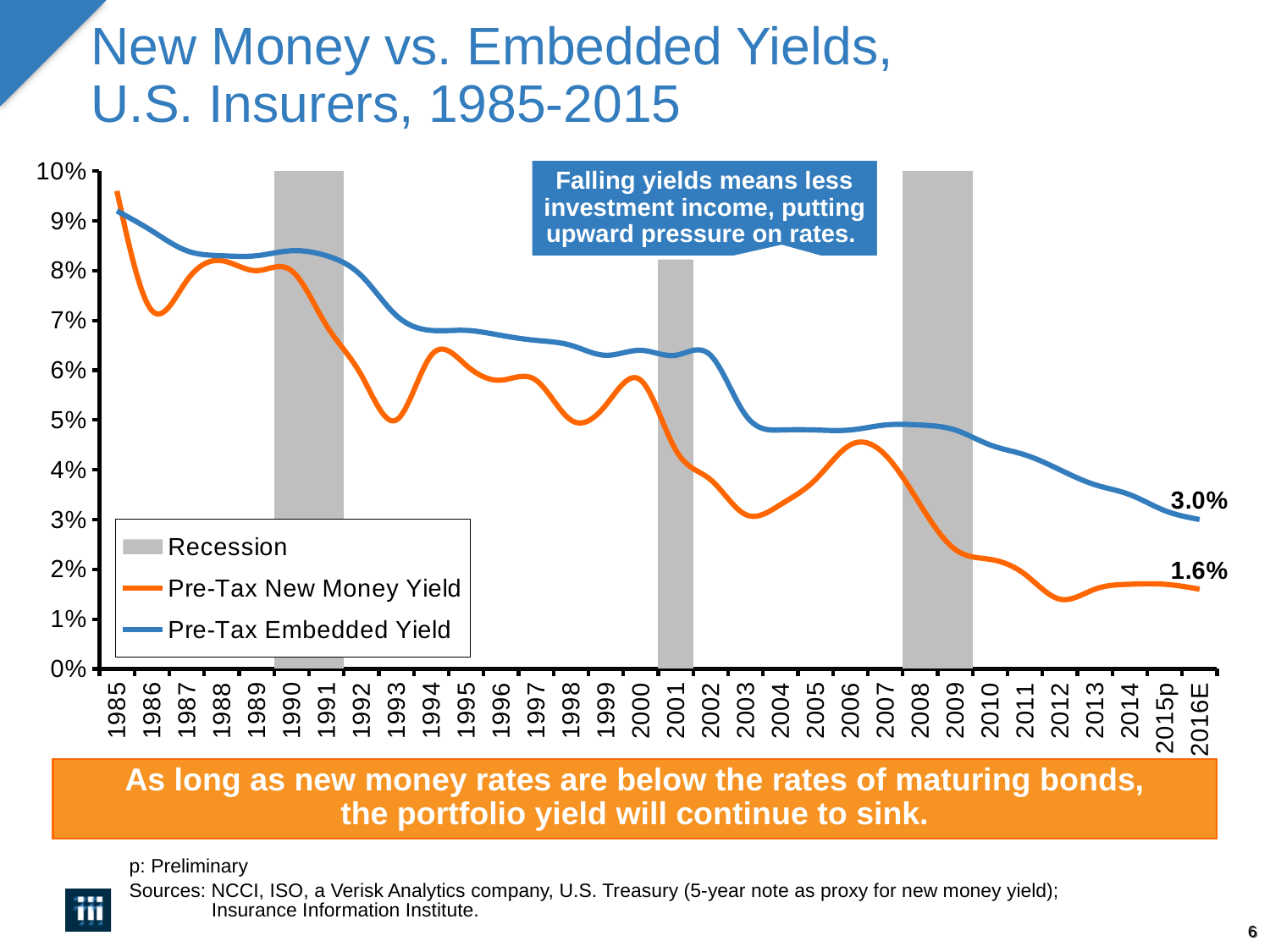
Is the Pre-Tax New Money Yield in 1985 greater or less than 9%? greater What is the Pre-Tax Embedded Yield for 2016E? 3.0% What kind of chart is shown on the slide? Line chart In 2016E, which is larger: the Pre-Tax Embedded Yield or the Pre-Tax New Money Yield? Pre-Tax Embedded Yield How many line series are plotted on the chart? 2 What do the grey shaded areas on the chart represent? Recession What is the Pre-Tax New Money Yield for 2016E? 1.6% What is the difference between the Pre-Tax Embedded Yield and the Pre-Tax New Money Yield in 2016E? 1.4% Is the Pre-Tax Embedded Yield in 2014 greater or less than 4%? less Is the Pre-Tax New Money Yield in 2012 greater or less than 2%? less Does the Pre-Tax Embedded Yield generally rise or fall from 1985 to 2016E? Fall In which year is the Pre-Tax New Money Yield at its highest? 1985